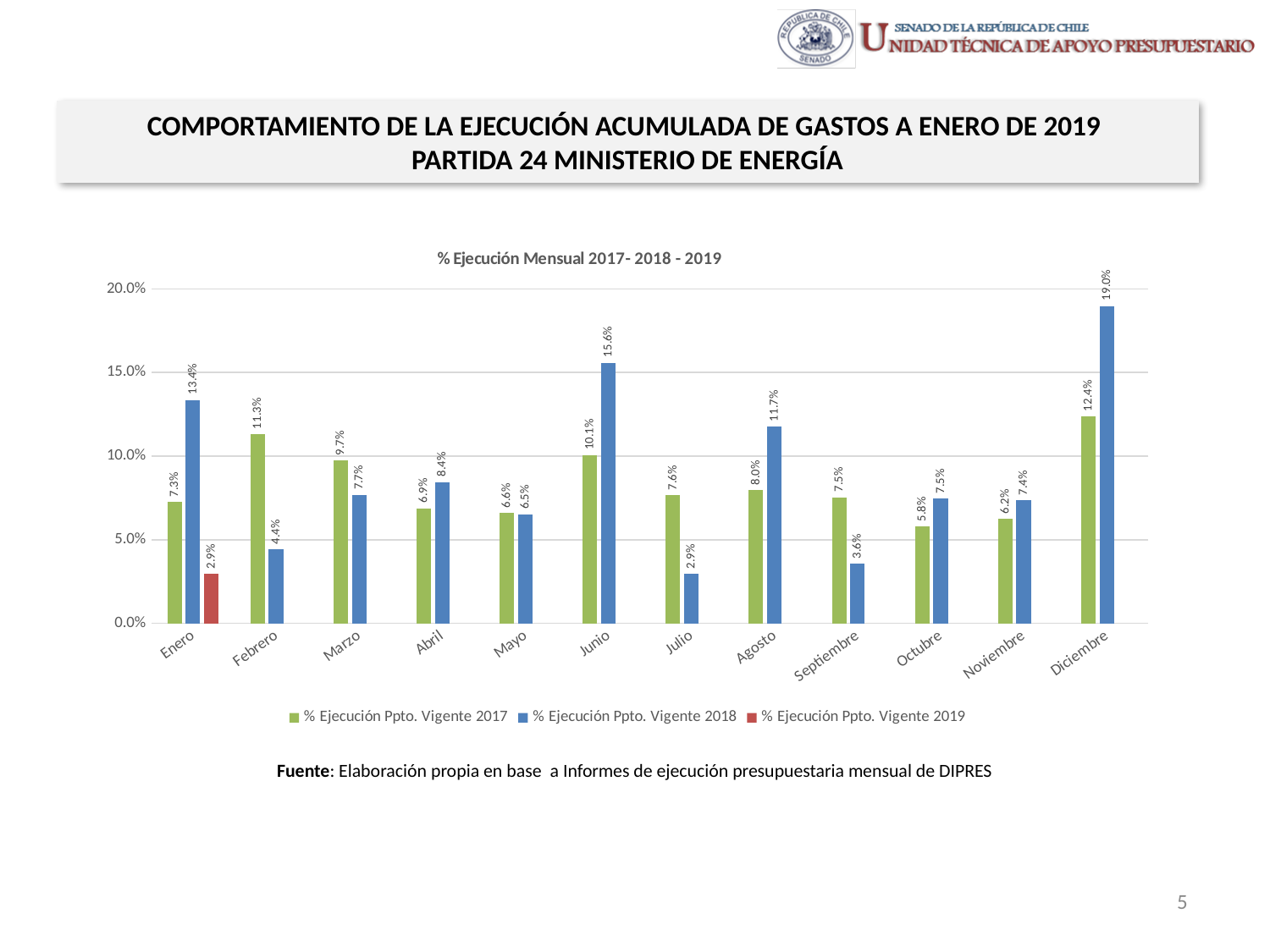
What is the title of the chart? % Ejecución Mensual 2017- 2018 - 2019 What is the value for Junio in the % Ejecución Ppto. Vigente 2018 series? 15.6% Which month has the lowest value in the % Ejecución Ppto. Vigente 2017 series? Octubre Which month has the highest value in the % Ejecución Ppto. Vigente 2018 series? Diciembre Which is larger for Febrero: the 2017 value or the 2018 value? 2017 What is the value for Enero in the % Ejecución Ppto. Vigente 2019 series? 2.9% What kind of chart is shown? Bar chart What is the value for Diciembre in the % Ejecución Ppto. Vigente 2017 series? 12.4% How many series does the legend list? 3 Is the value for Diciembre in the 2018 series greater or less than 15.0%? greater What is the difference between the 2018 and 2017 values for Enero? 6.1% How many months are shown on the x axis? 12